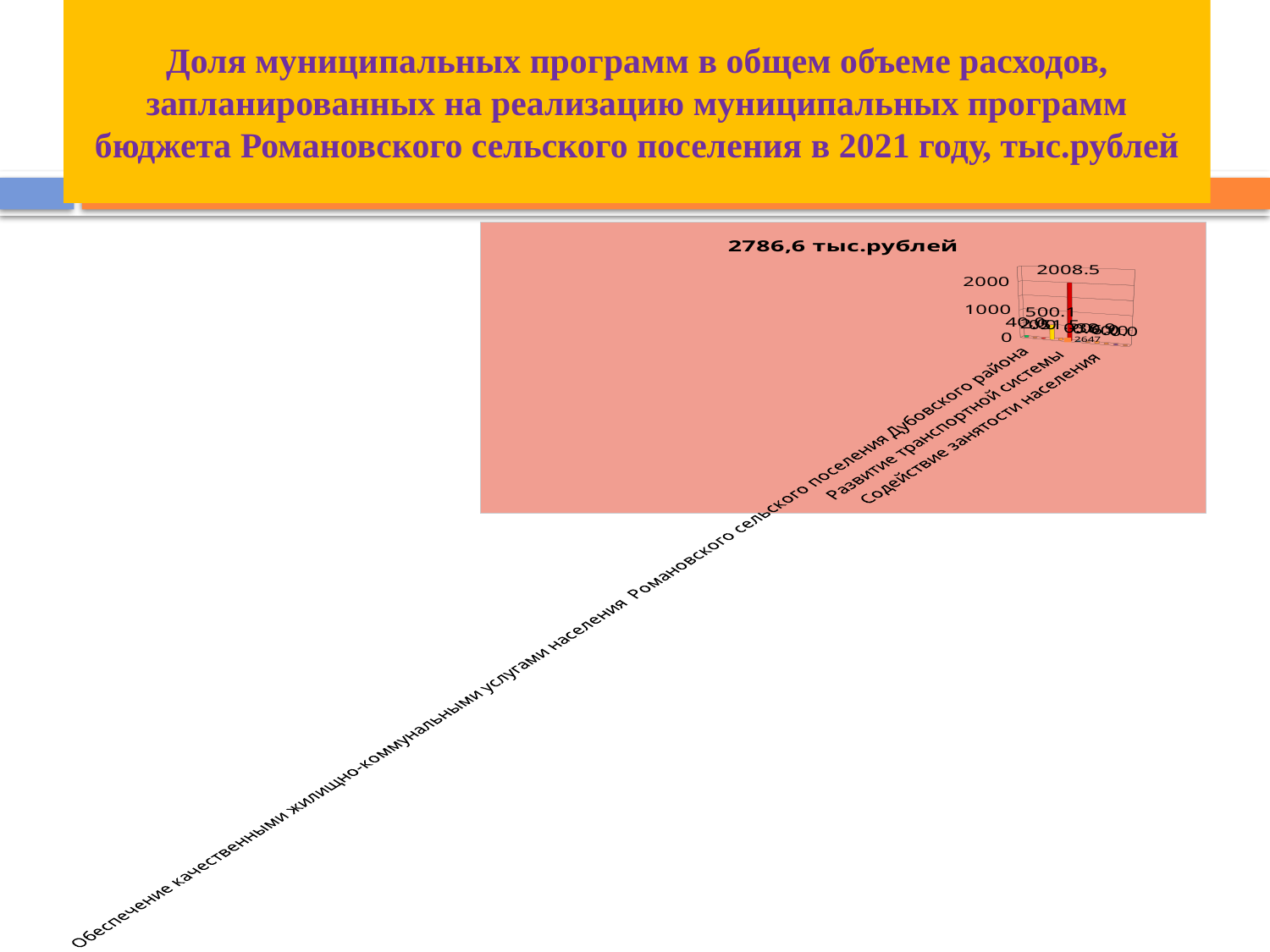
What kind of chart is shown on the slide? bar chart Is the value of the bar labelled 500.1 greater or less than 1000? less Which is larger, the bar labelled 2008.5 or the bar labelled 500.1? 2008.5 What is the highest tick value shown on the vertical axis? 2000 Is the value of the tallest bar (2008.5) greater or less than 2000? greater What is the difference between the bar labelled 2008.5 and the bar labelled 500.1? 1508.4 What is the title of the chart? 2786,6 тыс.рублей What is the largest data label shown on the chart? 2008.5